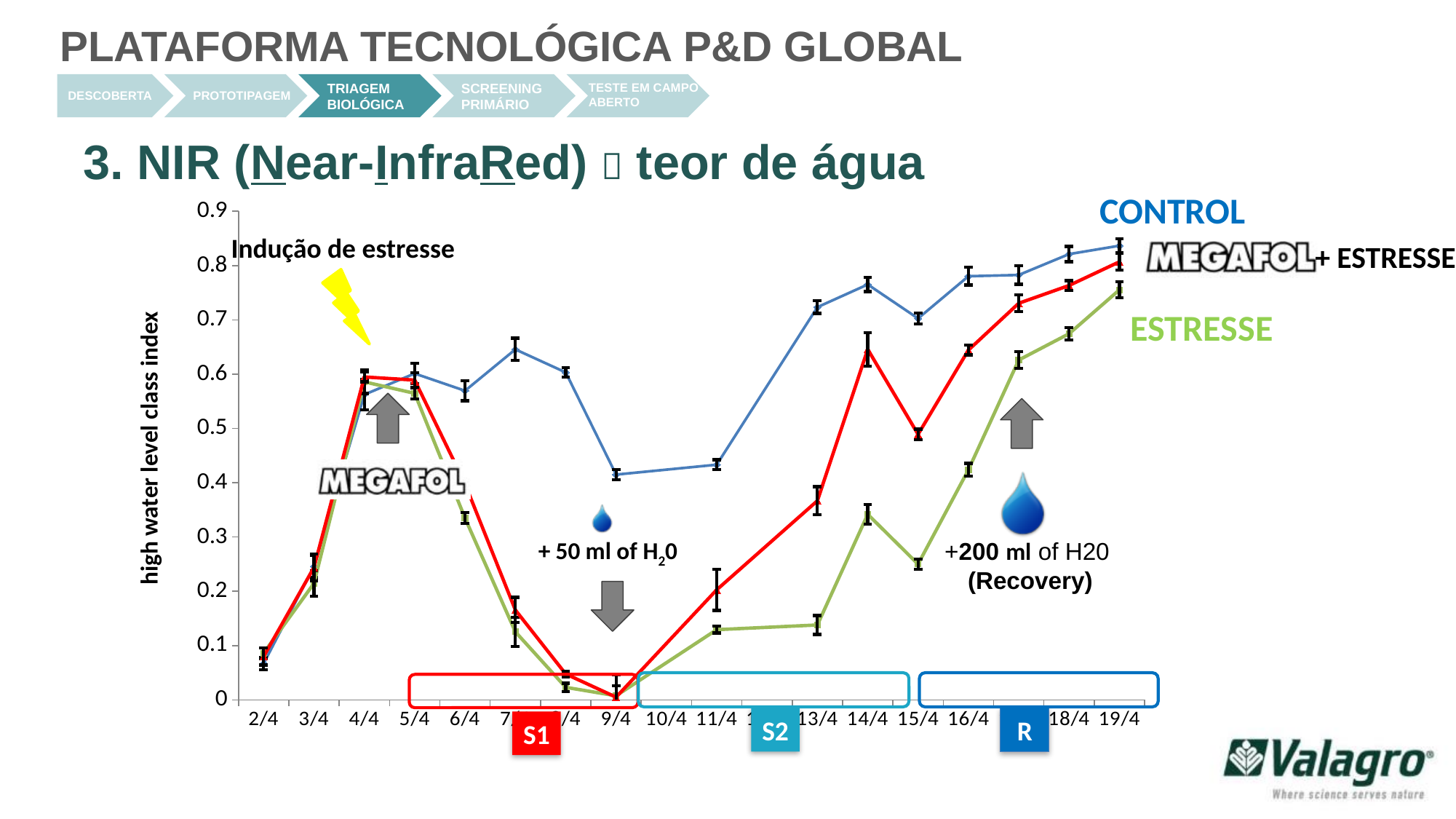
What is the label of the vertical axis? high water level class index What kind of chart is shown on the slide? line chart At 9/4, which is higher: CONTROL or MEGAFOL + ESTRESSE? CONTROL Is the MEGAFOL + ESTRESSE value at 14/4 greater or less than 0.6? greater Does the ESTRESSE series rise or fall between 5/4 and 9/4? fall Which series has the lowest value at 13/4? ESTRESSE Is the ESTRESSE value at 11/4 greater or less than 0.2? less At 16/4, which is higher: MEGAFOL + ESTRESSE or ESTRESSE? MEGAFOL + ESTRESSE Is the CONTROL value at 14/4 greater or less than 0.7? greater How many data series are plotted on the chart? 3